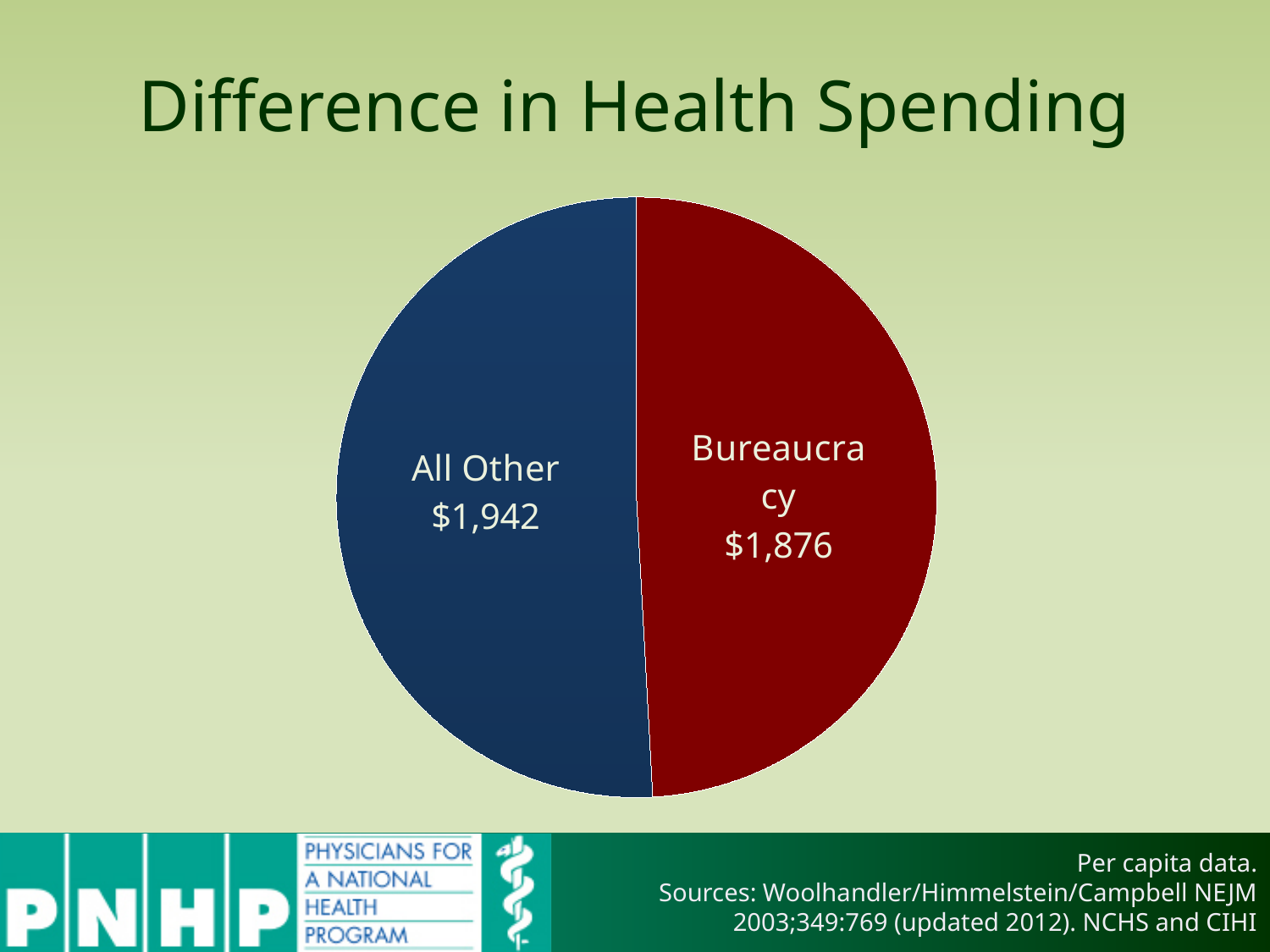
Which slice has the largest value? All Other How many slices does the pie chart have? 2 What kind of chart is shown on the slide? Pie chart What is the title of the chart? Difference in Health Spending What is the difference between the All Other value and the Bureaucracy value? $66 What is the value shown for the All Other slice? $1,942 What colour is the Bureaucracy slice? Red What is the value shown for the Bureaucracy slice? $1,876 Which slice has the smallest value? Bureaucracy What is the total of the two slices in the pie chart? $3,818 Which slice has the larger value, All Other or Bureaucracy? All Other